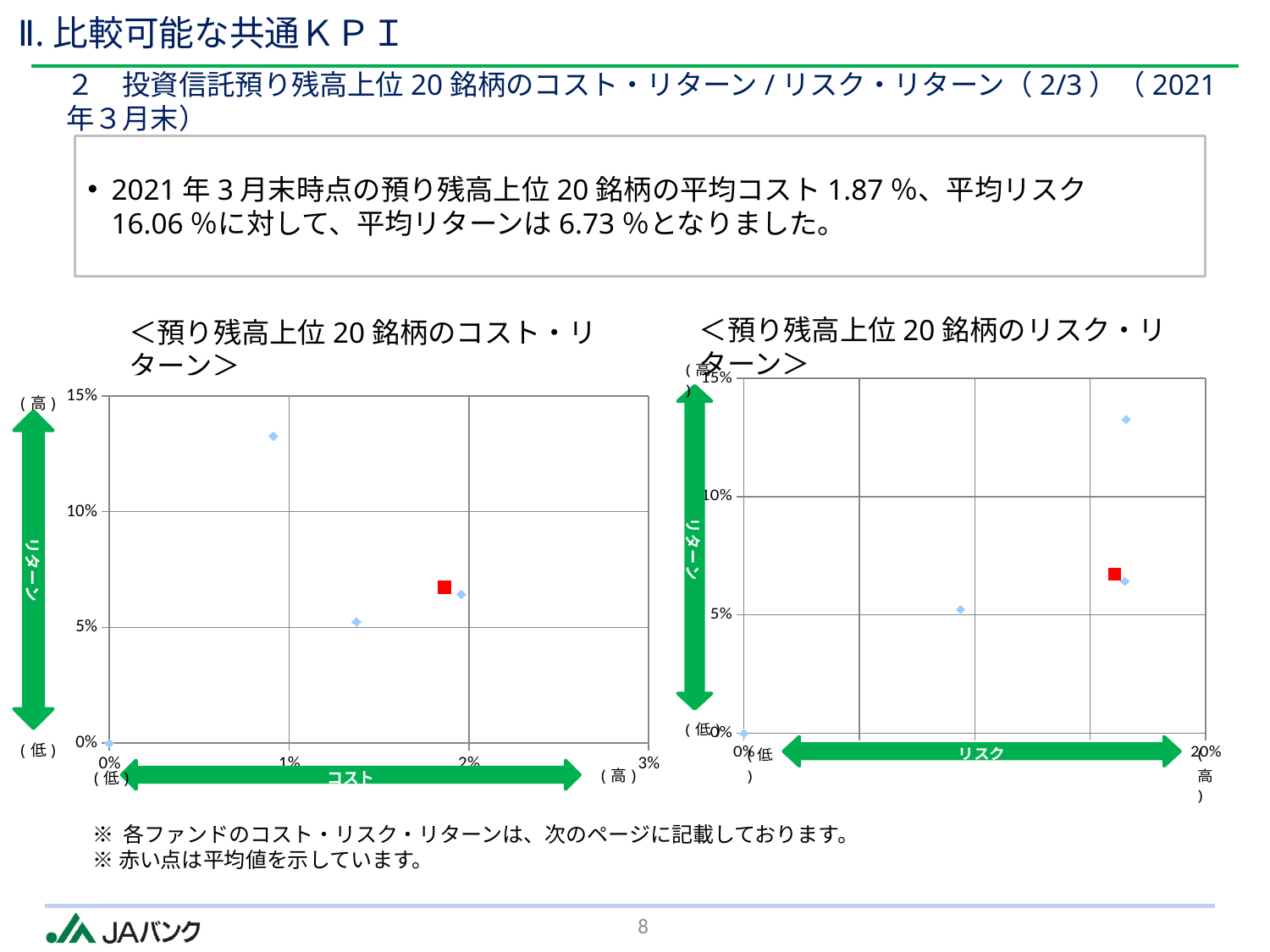
In the left chart (コスト・リターン), what average cost does the red point represent, according to the slide text? 1.87% In the right chart (リスク・リターン), what average risk does the red point represent, according to the slide text? 16.06% What is the label on the horizontal axis of the right chart (リスク・リターン)? リスク In the right chart (リスク・リターン), is the risk of the point with the highest return greater or less than 15%? greater What kind of chart is the right chart titled ＜預り残高上位20銘柄のリスク・リターン＞? scatter chart In the left chart (コスト・リターン), is the return of the red average point greater or less than 5%? greater In the left chart (コスト・リターン), what average return does the red point represent, according to the slide text? 6.73% In the right chart (リスク・リターン), is the return of the lowest-risk non-zero blue point greater or less than 10%? less What kind of chart is the left chart titled ＜預り残高上位20銘柄のコスト・リターン＞? scatter chart According to the note below the charts, what do the red points indicate? 平均値 (average values)